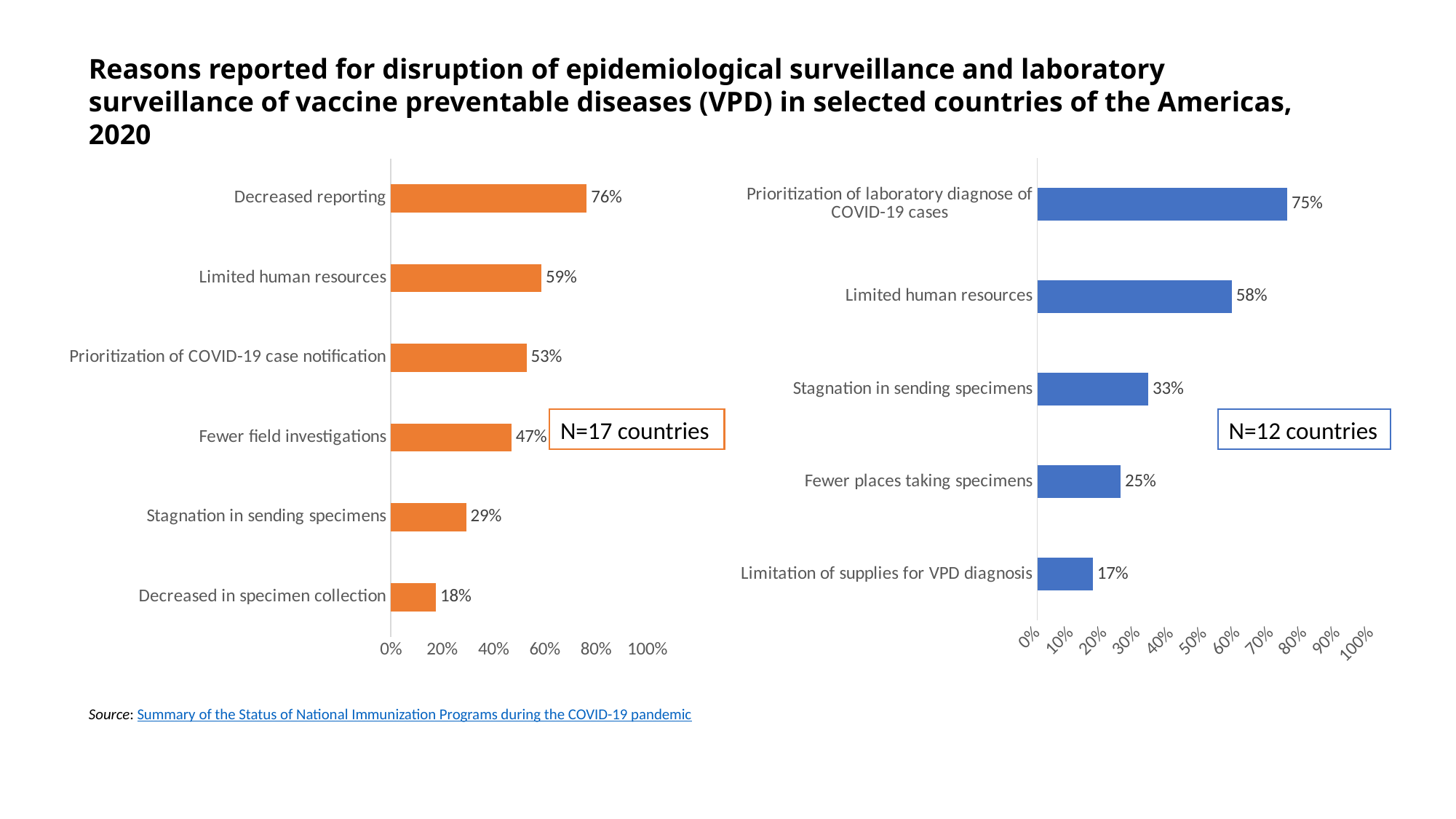
In the right (blue) chart, what is the difference between Fewer places taking specimens and Limitation of supplies for VPD diagnosis? 8% In the left (orange) chart, what is the value for Decreased reporting? 76% In the left (orange) chart, what is the difference between Decreased reporting and Limited human resources? 17% In the left (orange) chart, which category has the lowest value? Decreased in specimen collection In the right (blue) chart, what is the value for Stagnation in sending specimens? 33% What kind of chart is the right (blue) chart? Bar chart How many countries does the right (blue) chart's annotation say are included? N=12 countries In the left (orange) chart, is the value for Fewer field investigations greater or less than 40%? greater How many categories are shown in the left (orange) chart? 6 In the right (blue) chart, which category has the highest value? Prioritization of laboratory diagnose of COVID-19 cases Which is larger: Limited human resources in the left (orange) chart or Limited human resources in the right (blue) chart? Left (orange) chart, 59% How many categories are shown in the right (blue) chart? 5